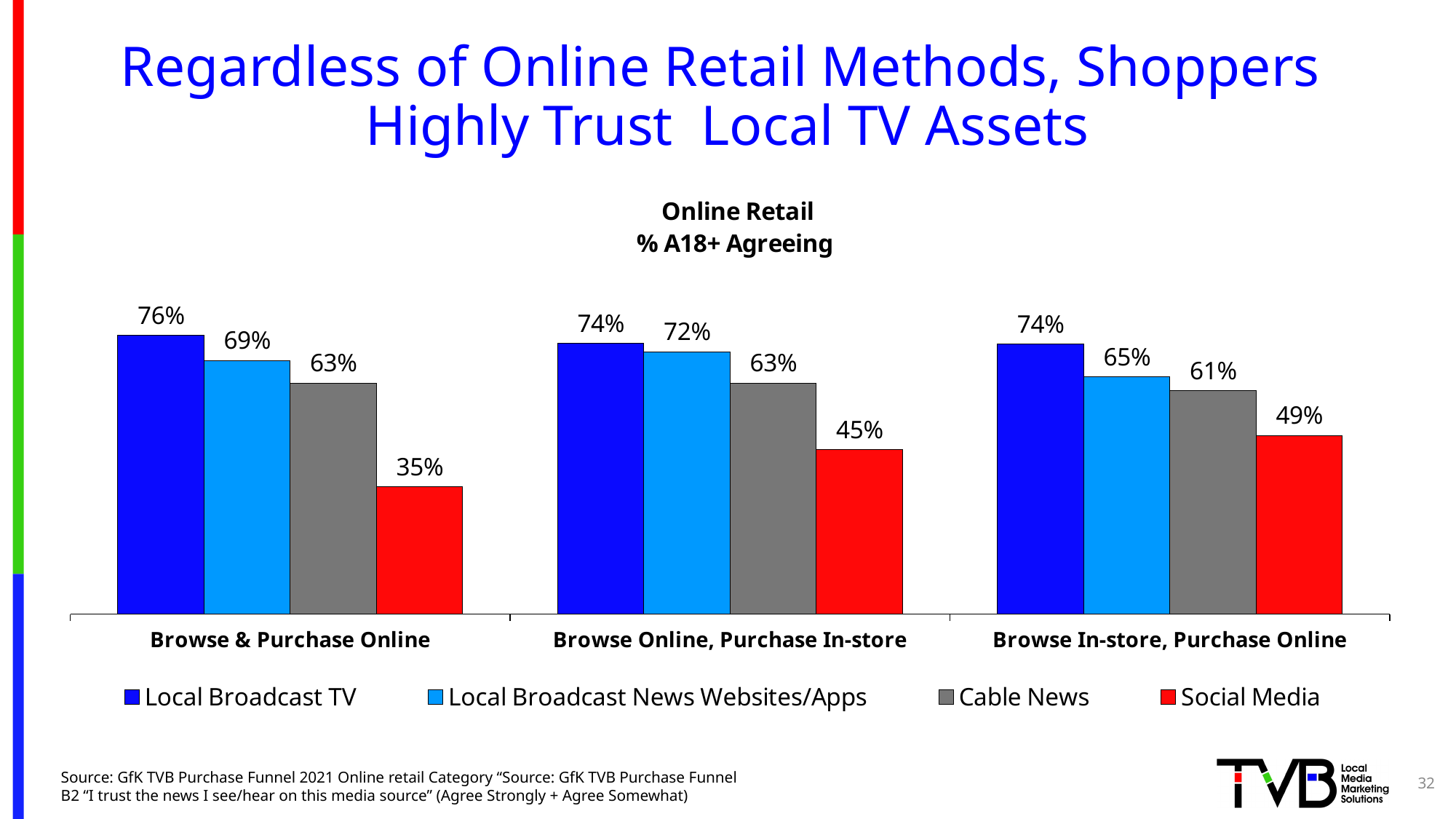
What is the value for Cable News in the Browse In-store, Purchase Online category? 61% Which series has the highest value in the Browse Online, Purchase In-store category? Local Broadcast TV Which is larger: Local Broadcast News Websites/Apps in Browse Online, Purchase In-store or Local Broadcast News Websites/Apps in Browse In-store, Purchase Online? Browse Online, Purchase In-store What kind of chart is shown on the slide? Bar chart What is the difference between Local Broadcast TV and Social Media in the Browse & Purchase Online category? 41 percentage points What is the value for Social Media in the Browse Online, Purchase In-store category? 45% What is the title of the chart? Online Retail % A18+ Agreeing What is the value for Local Broadcast TV in the Browse & Purchase Online category? 76% Which series has the lowest value in the Browse & Purchase Online category? Social Media How many series does the legend list? 4 How many categories are shown on the x axis? 3 What colour represents Cable News in the chart? Gray